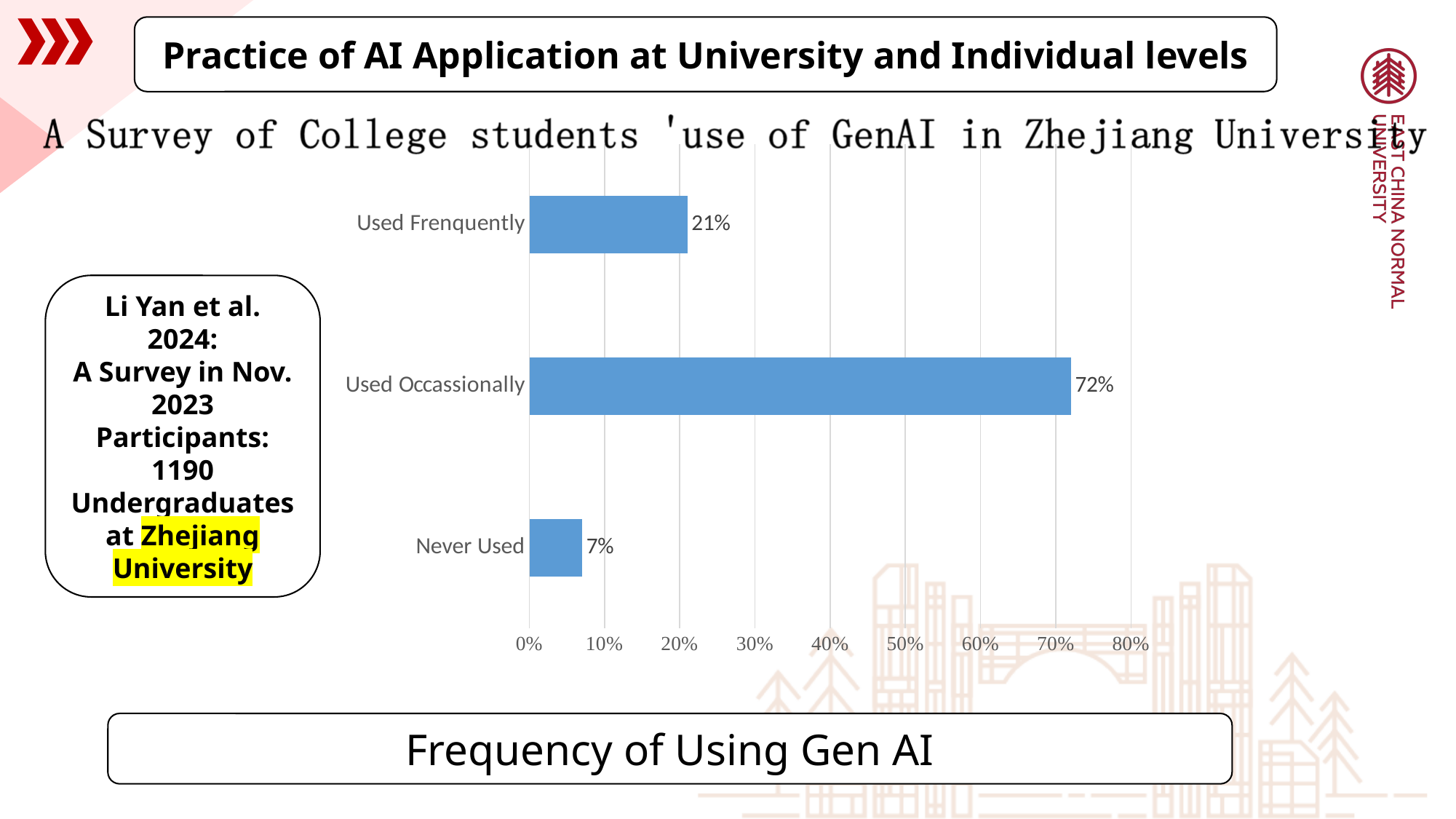
What percentage of students reported 'Never Used'? 7% What is the difference between 'Used Occassionally' and 'Used Frenquently'? 51% How many categories are shown in the chart? 3 Which is larger, 'Used Frenquently' or 'Never Used'? Used Frenquently Which category has the highest percentage? Used Occassionally What percentage of students reported 'Used Occassionally'? 72% What percentage of students reported 'Used Frenquently'? 21% Which category has the lowest percentage? Never Used What is the caption shown below the chart? Frequency of Using Gen AI What type of chart is shown on the slide? Bar chart Is the value for 'Used Occassionally' greater or less than 70%? greater What is the difference between 'Used Frenquently' and 'Never Used'? 14%